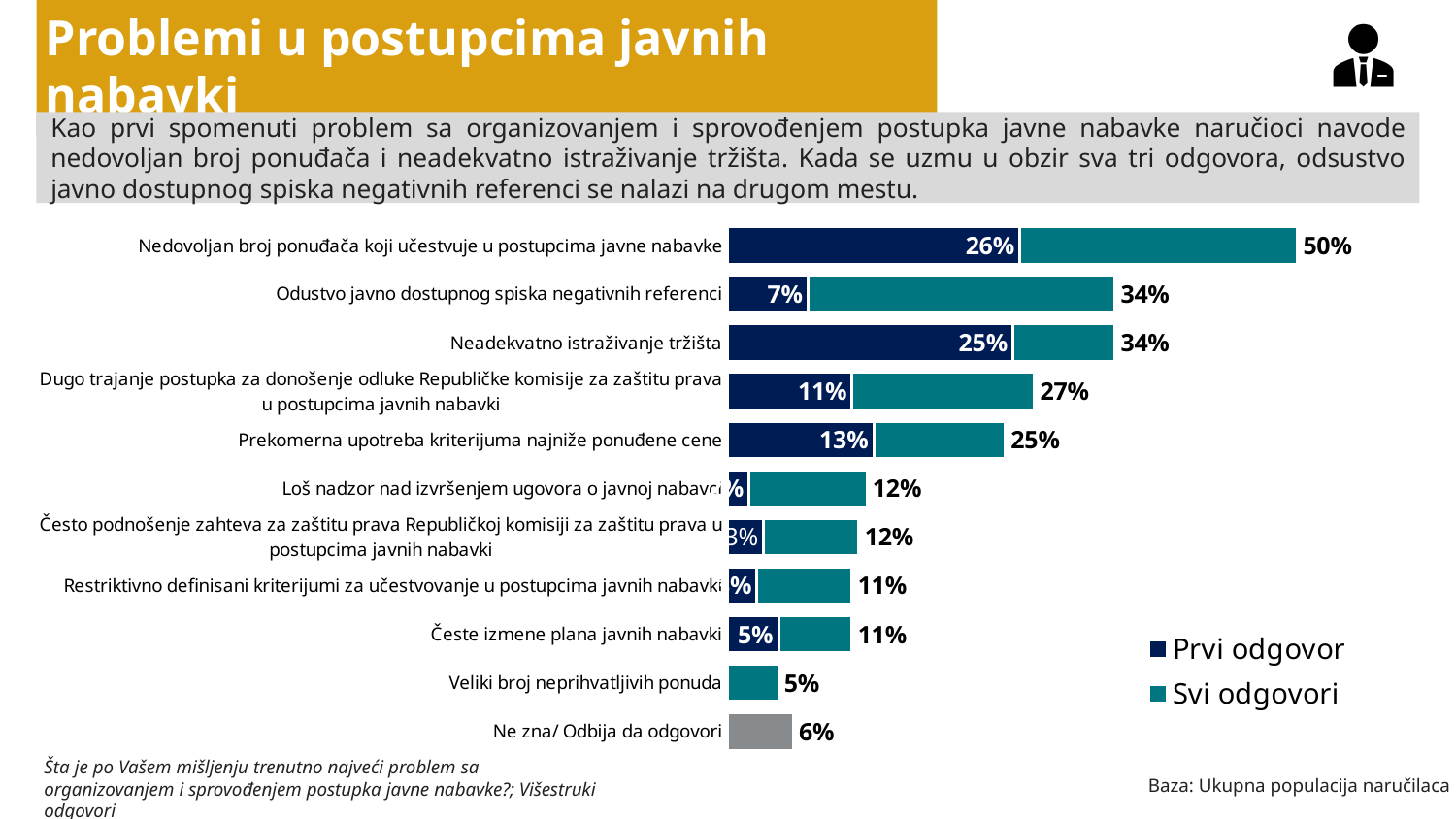
What is the value shown for 'Ne zna/ Odbija da odgovori'? 6% How many series does the legend list? 2 What type of chart is shown on the slide? bar chart What are the two legend entries of the chart? Prvi odgovor, Svi odgovori What is the 'Svi odgovori' value for 'Prekomerna upotreba kriterijuma najniže ponuđene cene'? 25% What is the difference between the 'Svi odgovori' and 'Prvi odgovor' values for 'Dugo trajanje postupka za donošenje odluke Republičke komisije za zaštitu prava u postupcima javnih nabavki'? 16% What is the 'Svi odgovori' value for 'Nedovoljan broj ponuđača koji učestvuje u postupcima javne nabavke'? 50% What is the 'Prvi odgovor' value for 'Odustvo javno dostupnog spiska negativnih referenci'? 7% Which is larger: the 'Prvi odgovor' value for 'Neadekvatno istraživanje tržišta' or for 'Prekomerna upotreba kriterijuma najniže ponuđene cene'? Neadekvatno istraživanje tržišta Which category has the highest 'Svi odgovori' value? Nedovoljan broj ponuđača koji učestvuje u postupcima javne nabavke How many categories are shown on the chart? 11 What is the 'Prvi odgovor' value for 'Neadekvatno istraživanje tržišta'? 25%